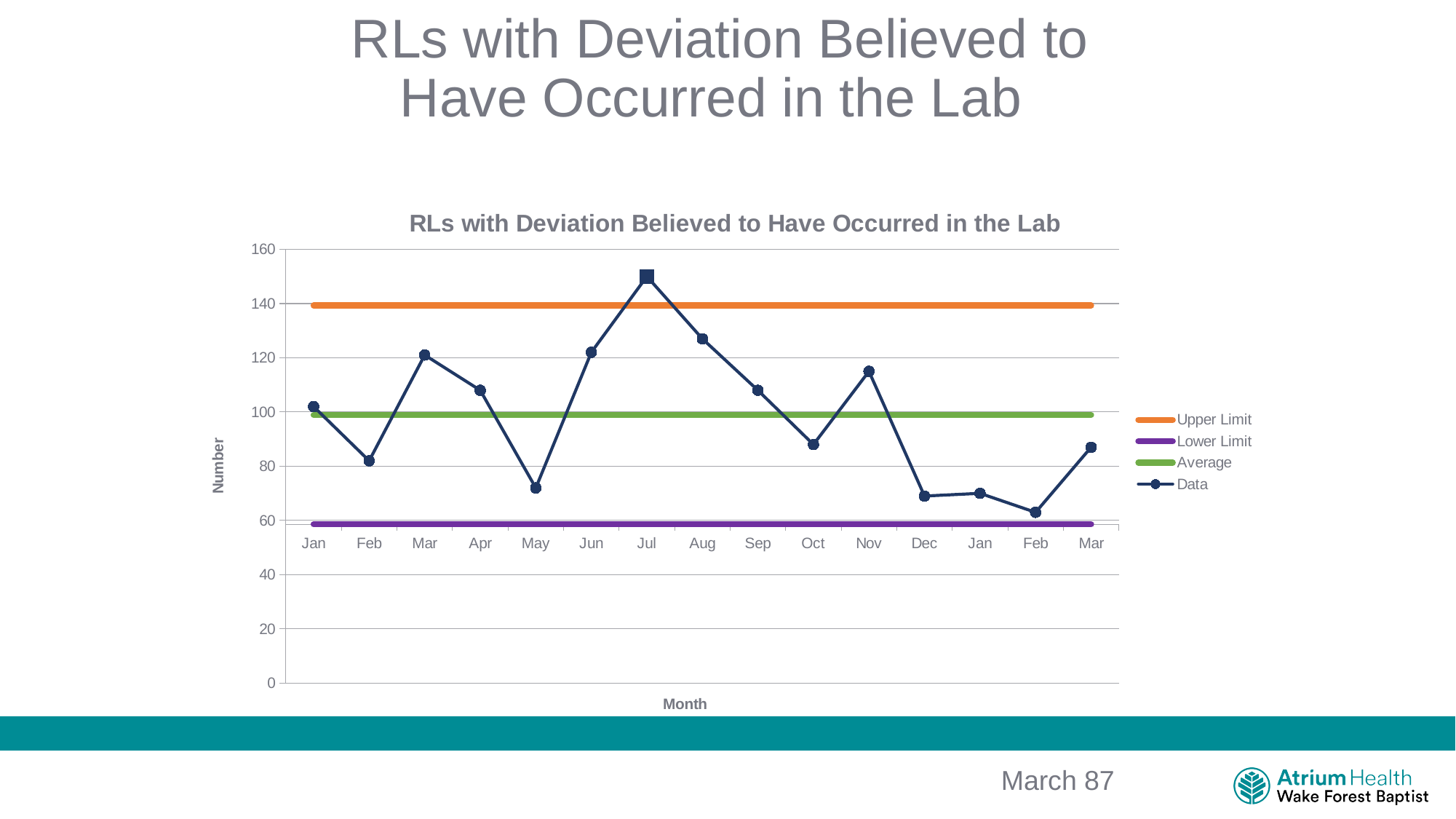
Is the Data value for Jul greater or less than 140? greater Which is larger, the Data value for Jul or for Aug? Jul Do the Data values rise or fall from Jul to Oct? fall Is the Data value for May greater or less than 80? less Which is larger, the Data value for Nov or for Oct? Nov Is the Data value for Nov greater or less than 100? greater What colour is the Upper Limit line in the chart? orange How many months are plotted along the x axis? 15 What kind of chart is shown on the slide? line chart How many series does the legend list? 4 Which month has the highest value for the Data series? Jul